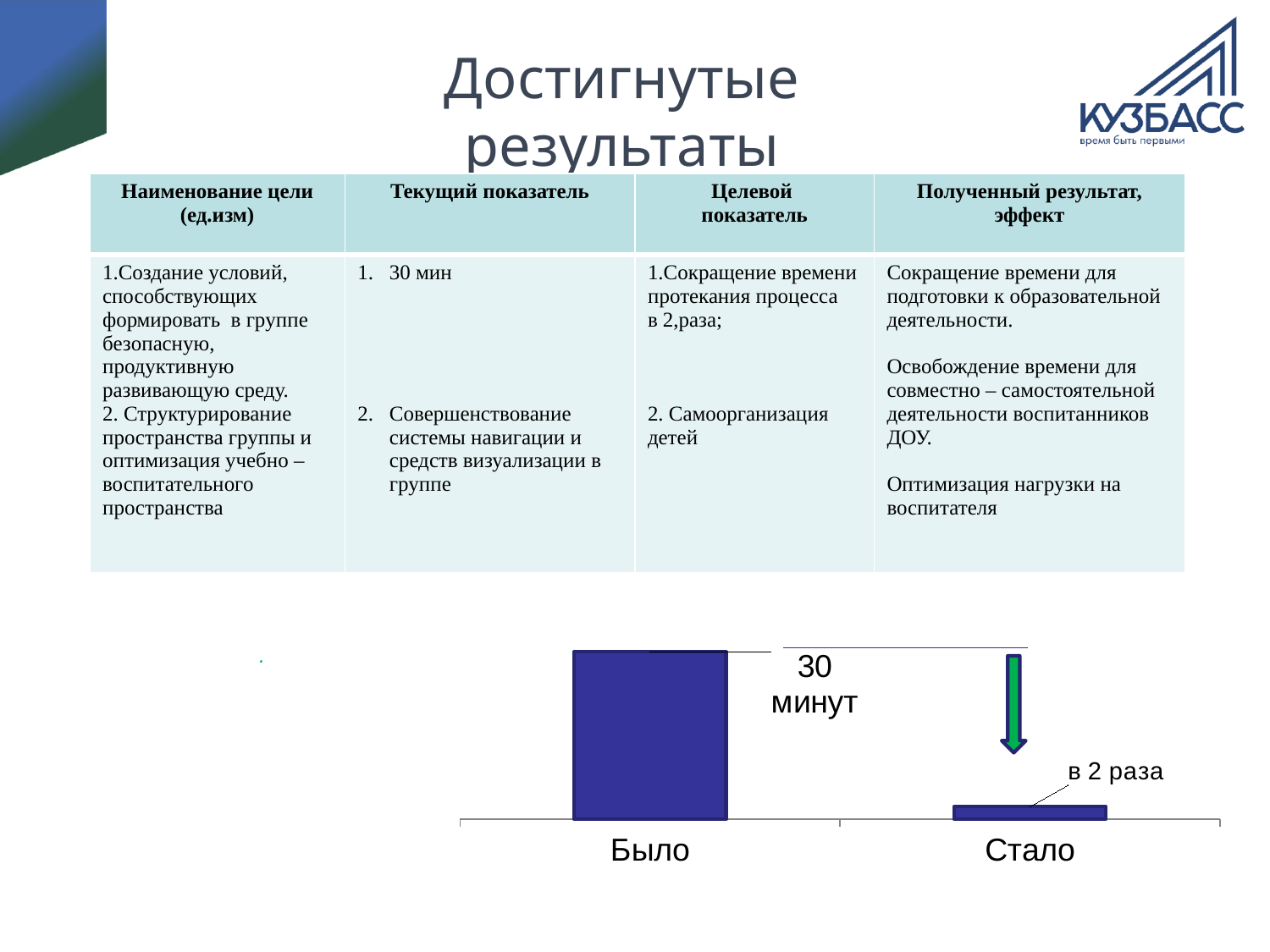
What value is labelled on the bar for "Было"? 30 минут How many categories are shown on the x axis of the bar chart? 2 Which category has the lowest bar in the chart? Стало Do the bar values rise or fall from "Было" to "Стало"? fall Which bar is taller, "Было" or "Стало"? Было Which category has the highest bar in the chart? Было What kind of chart is shown at the bottom of the slide? bar chart What are the two category labels on the x axis of the chart? Было, Стало What text label is attached to the "Стало" bar? в 2 раза